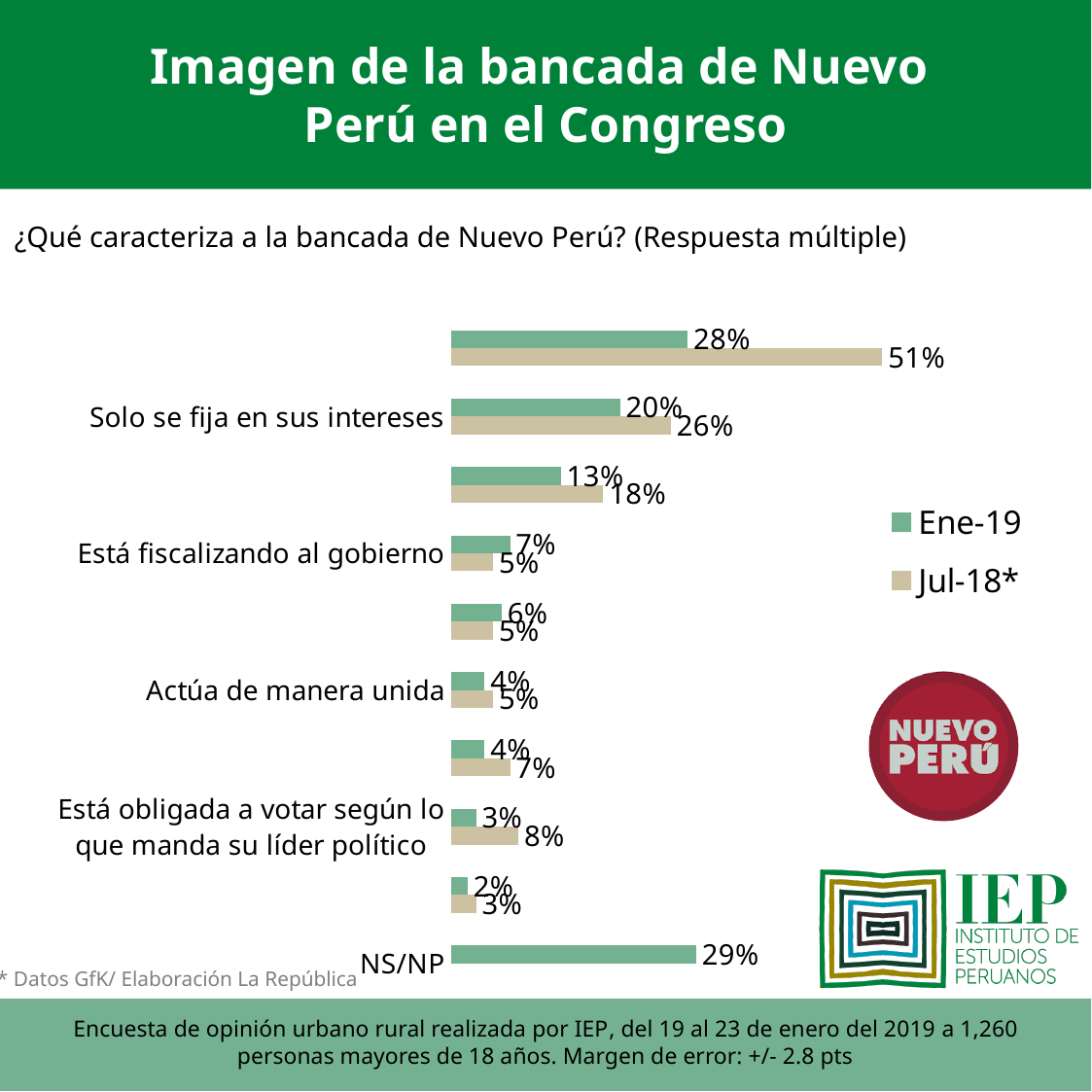
What is the Ene-19 value for NS/NP? 29% What is the Jul-18* value for "Está obligada a votar según lo que manda su líder político"? 8% Which labelled category has the highest Ene-19 value? NS/NP What kind of chart is shown on the slide? Bar chart What is the difference between the Jul-18* and Ene-19 values for "Solo se fija en sus intereses"? 6% What is the difference between the Jul-18* and Ene-19 values for "Está obligada a votar según lo que manda su líder político"? 5% For "Está fiscalizando al gobierno", which is larger: the Ene-19 value or the Jul-18* value? Ene-19 For "Actúa de manera unida", which is larger: the Ene-19 value or the Jul-18* value? Jul-18* What is the Ene-19 value for "Está fiscalizando al gobierno"? 7% How many series does the legend list? 2 What is the Jul-18* value for "Solo se fija en sus intereses"? 26% What is the Ene-19 value for "Solo se fija en sus intereses"? 20%